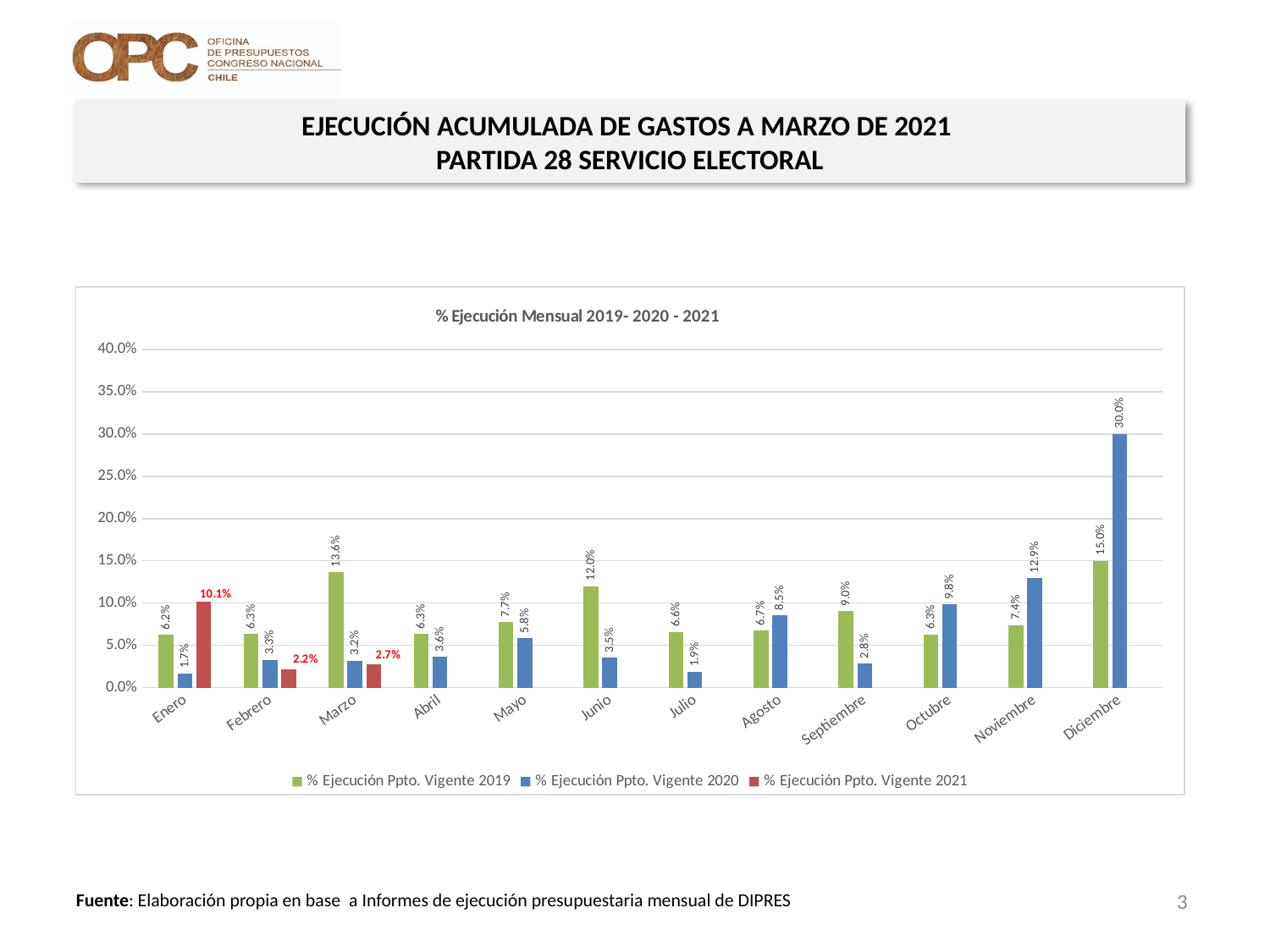
What is the value for % Ejecución Ppto. Vigente 2020 in Diciembre? 30.0% What is the value for % Ejecución Ppto. Vigente 2019 in Marzo? 13.6% What is the difference between the 2020 and 2019 values in Diciembre? 15.0% What is the title of the chart? % Ejecución Mensual 2019- 2020 - 2021 How many series does the legend list? 3 In which month is the % Ejecución Ppto. Vigente 2020 value lowest? Enero Which is larger in Agosto, the 2019 value or the 2020 value? 2020 What is the difference between the 2021 and 2020 values in Marzo? -0.5% What type of chart is shown on the slide? bar chart In which month is the % Ejecución Ppto. Vigente 2020 value highest? Diciembre What is the value for % Ejecución Ppto. Vigente 2021 in Enero? 10.1% How many months are shown on the x axis? 12